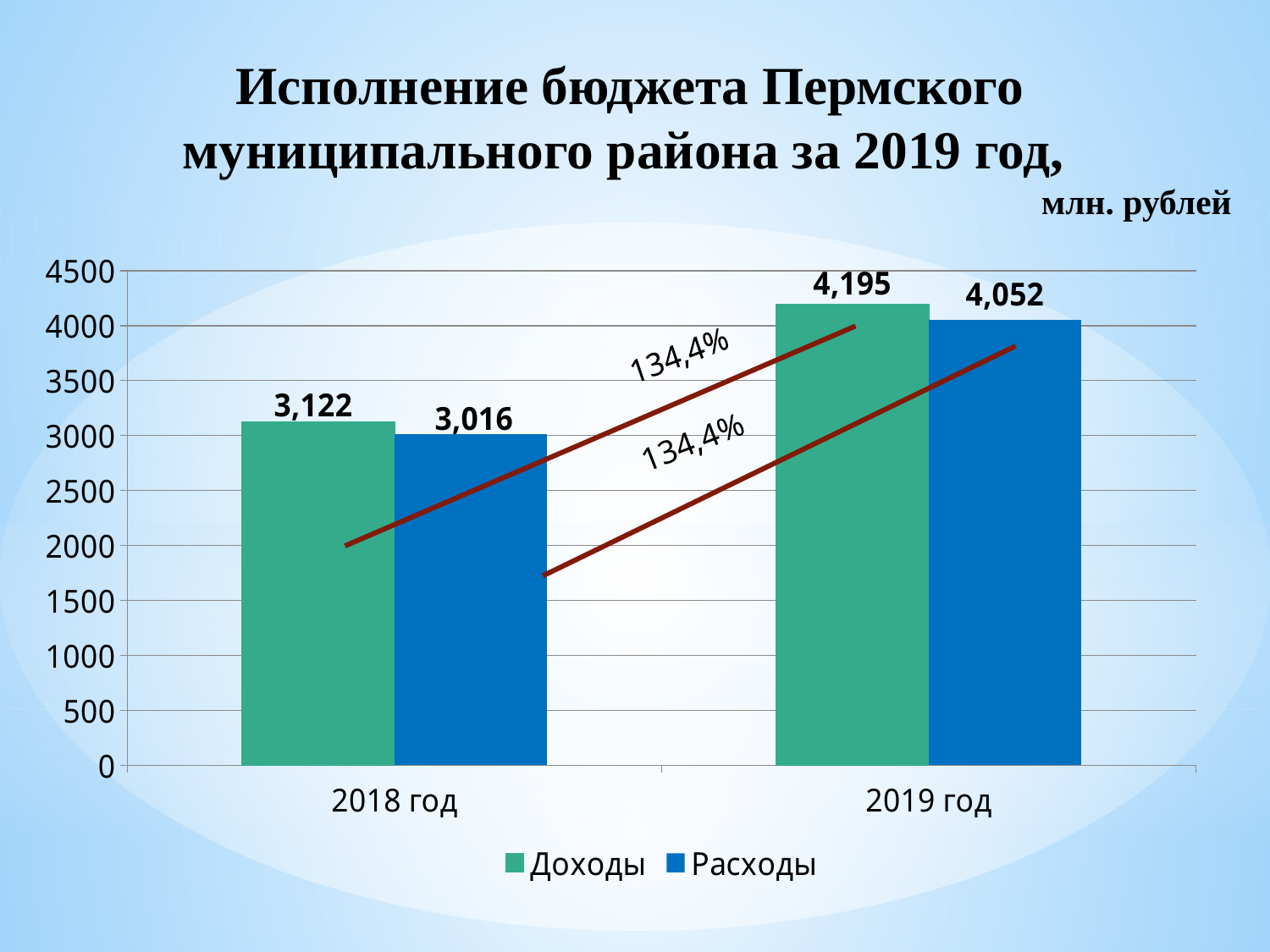
Which is larger in 2018 год, Доходы or Расходы? Доходы What growth percentage is written next to the lines connecting the 2018 and 2019 bars? 134,4% Which year has the highest value for Доходы? 2019 год What is the difference between Доходы in 2019 год and Доходы in 2018 год? 1,073 How many series does the legend list? 2 How many categories are shown on the x axis? 2 What kind of chart is shown on the slide? Bar chart Which bar has the lowest value on the chart? Расходы, 2018 год What is the value of Доходы for 2018 год? 3,122 What is the value of Расходы for 2019 год? 4,052 What is the difference between Доходы and Расходы in 2019 год? 143 What is the value of Расходы for 2018 год? 3,016